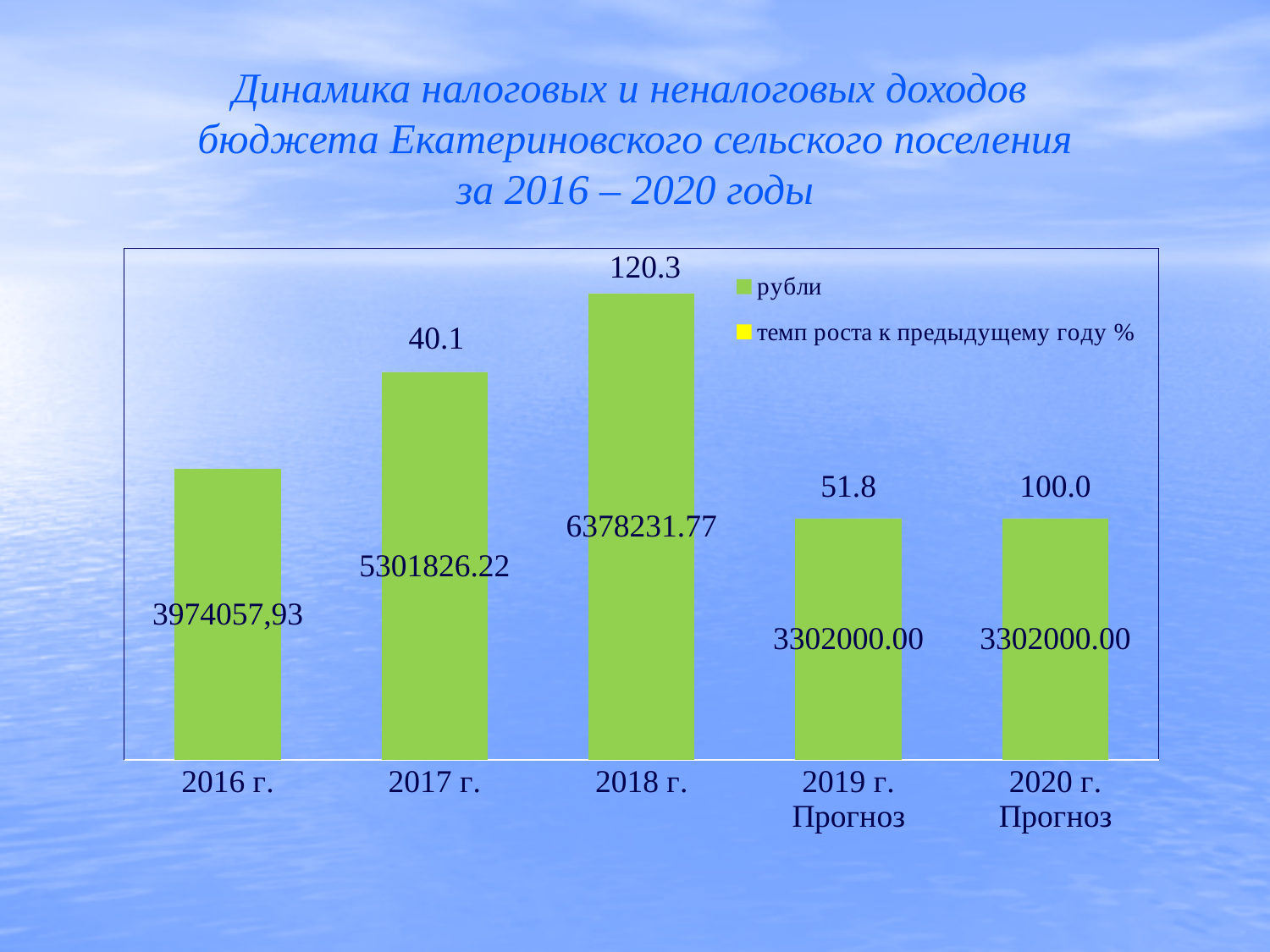
What growth rate to the previous year (темп роста к предыдущему году %) is shown for 2019 г. Прогноз? 51.8 How many categories (years) are shown on the x axis? 5 What is the value in rubles for 2019 г. Прогноз? 3302000.00 Do the values in rubles rise or fall from 2016 г. to 2018 г.? rise Which has the larger value in rubles, 2017 г. or 2016 г.? 2017 г. How many series does the legend list? 2 What is the difference in rubles between 2018 г. and 2017 г.? 1076405.55 Which year has the highest value in rubles? 2018 г. What growth rate to the previous year (темп роста к предыдущему году %) is shown for 2018 г.? 120.3 What is the value in rubles for 2017 г.? 5301826.22 What is the value in rubles for 2018 г.? 6378231.77 What kind of chart is shown on the slide? bar chart